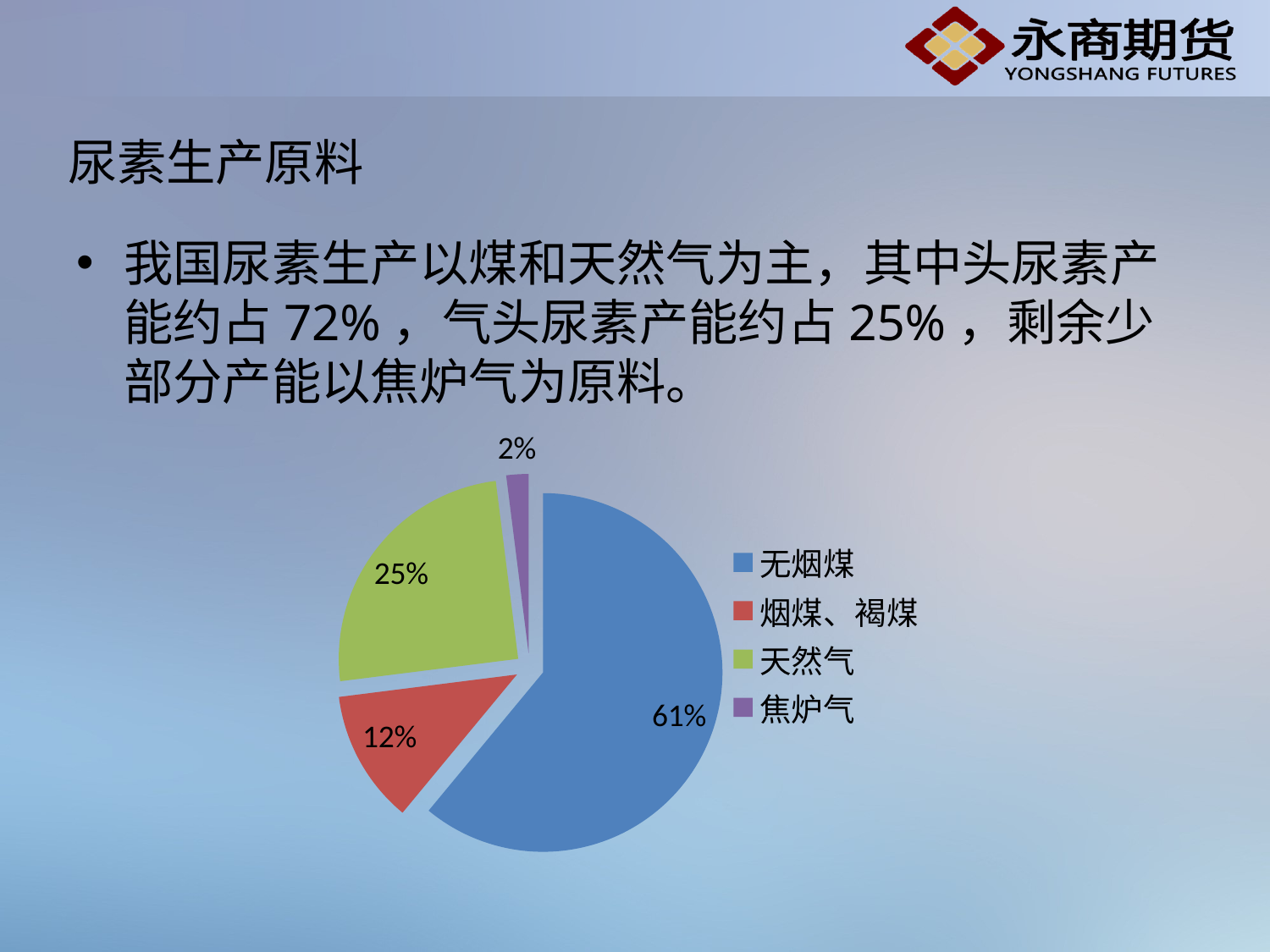
What share of the pie does 无烟煤 have? 61% What share of the pie does 焦炉气 have? 2% What is the difference between the shares of 天然气 and 烟煤、褐煤? 13% Which is larger, the share of 烟煤、褐煤 or the share of 焦炉气? 烟煤、褐煤 What is the difference between the shares of 无烟煤 and 天然气? 36% What share of the pie does 天然气 have? 25% What kind of chart is shown on the slide? pie chart What colour is the slice for 天然气? green How many categories does the pie chart have? 4 Which category has the largest slice of the pie? 无烟煤 Which category has the smallest slice of the pie? 焦炉气